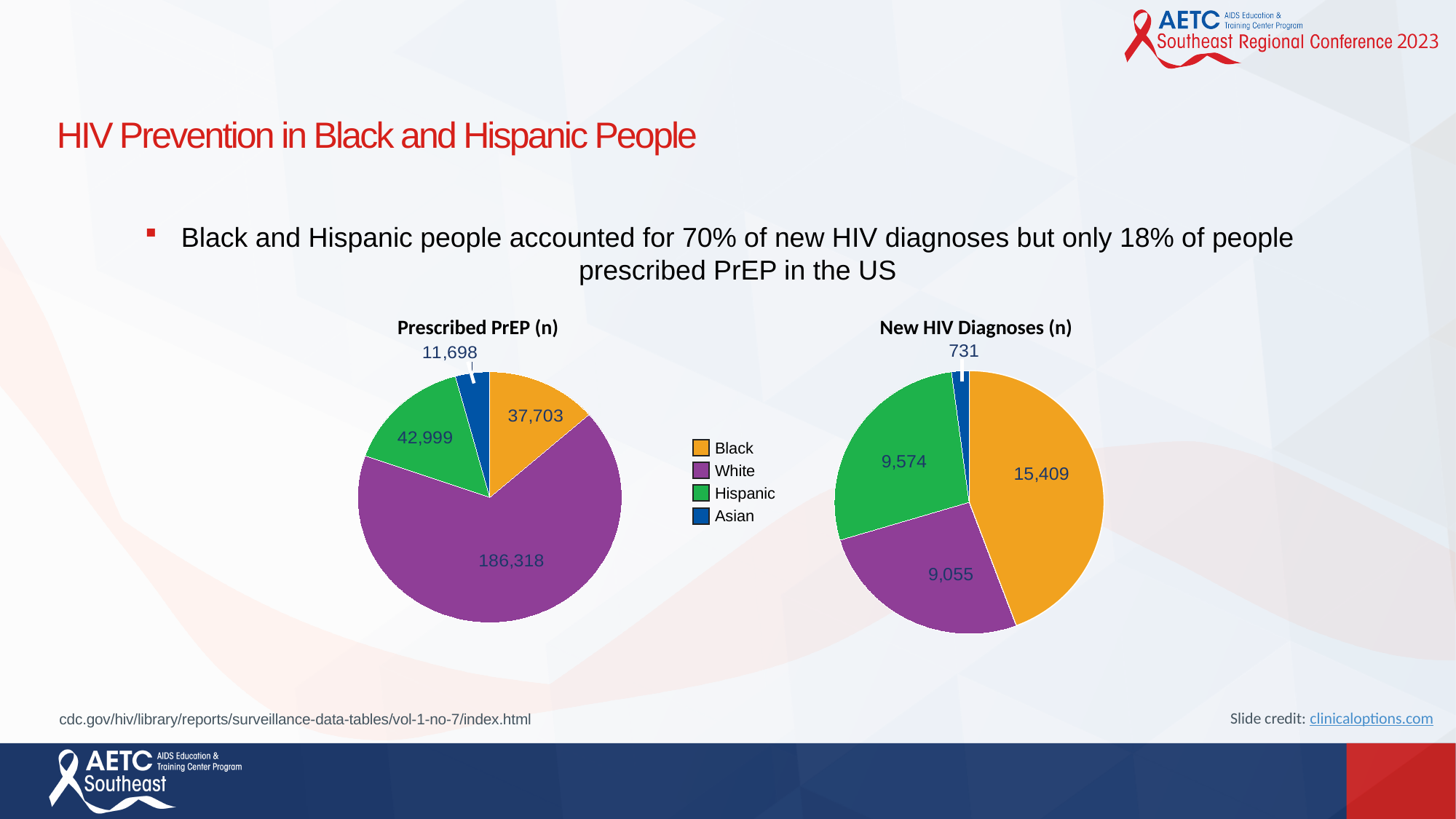
In the New HIV Diagnoses (n) chart, what is the value for Asian? 731 In the Prescribed PrEP (n) chart, what is the value for Hispanic? 42,999 In the New HIV Diagnoses (n) chart, which group has the largest slice? Black In the New HIV Diagnoses (n) chart, which is larger, the Hispanic value or the White value? Hispanic In the Prescribed PrEP (n) chart, what is the value for White? 186,318 In the New HIV Diagnoses (n) chart, which group has the smallest slice? Asian How many groups does the legend list? 4 In the New HIV Diagnoses (n) chart, what is the difference between the Black and Hispanic values? 5,835 What type of charts are shown on the slide? Pie charts In the New HIV Diagnoses (n) chart, what is the value for Black? 15,409 In the Prescribed PrEP (n) chart, which group has the largest slice? White In the Prescribed PrEP (n) chart, what is the difference between the White and Black values? 148,615